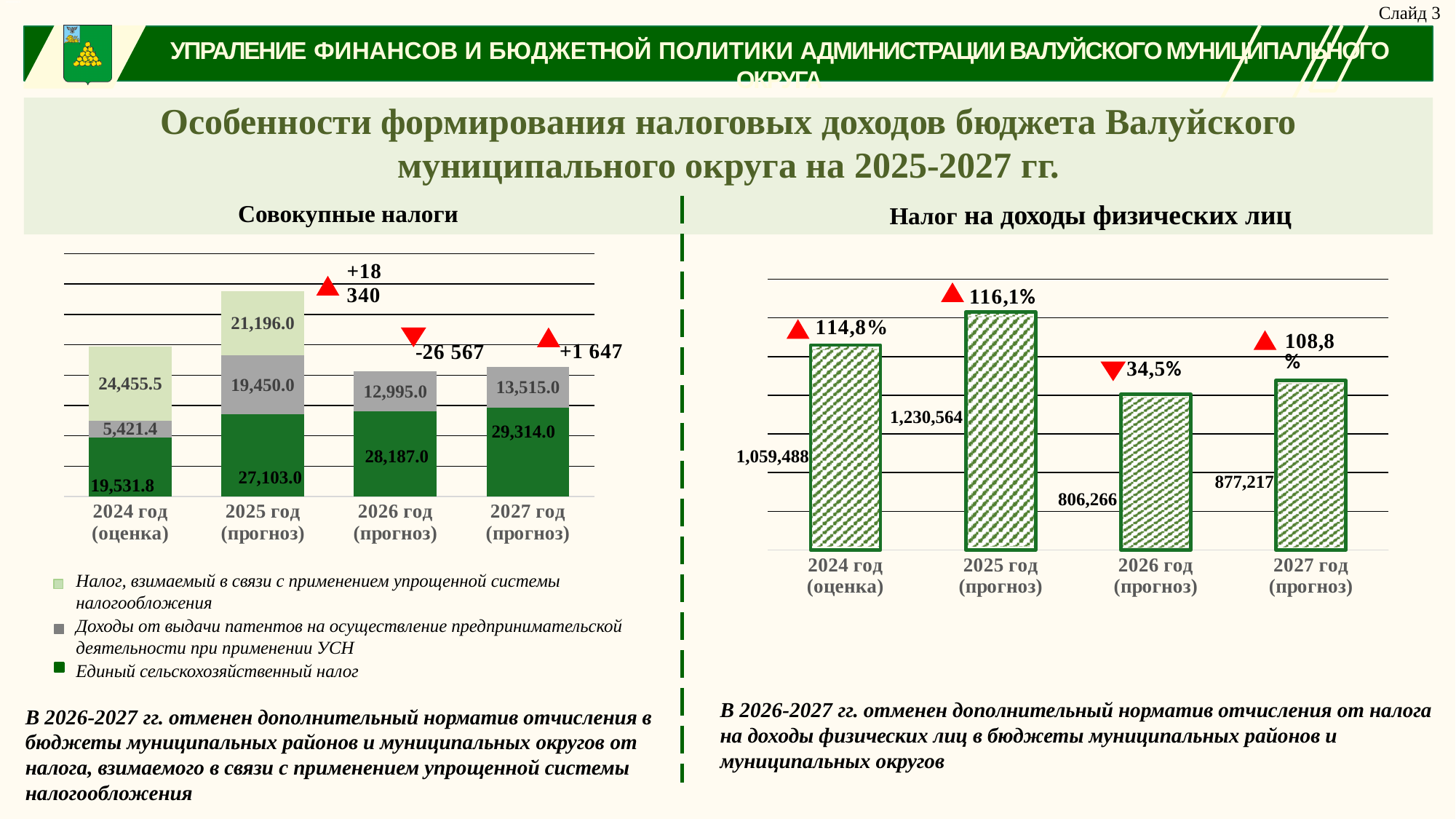
How many years are shown on the x axis of the chart 'Налог на доходы физических лиц'? 4 What kind of chart is 'Налог на доходы физических лиц'? bar chart In the chart 'Совокупные налоги', what is the total of the stacked bar for 2026 год (прогноз)? 41,182.0 In the chart 'Налог на доходы физических лиц', which year has the highest value? 2025 год (прогноз) In the chart 'Налог на доходы физических лиц', what is the value for 2025 год (прогноз)? 1,230,564 In the chart 'Совокупные налоги', is the value of Единый сельскохозяйственный налог larger for 2025 год (прогноз) or 2027 год (прогноз)? 2027 год (прогноз) In the chart 'Налог на доходы физических лиц', what is the difference between the values for 2025 год (прогноз) and 2024 год (оценка)? 171,076 In the chart 'Налог на доходы физических лиц', which year has the lowest value? 2026 год (прогноз) In the chart 'Совокупные налоги', what is the value of Доходы от выдачи патентов for 2024 год (оценка)? 5,421.4 How many series does the legend of the chart 'Совокупные налоги' list? 3 In the chart 'Совокупные налоги', what is the value of Единый сельскохозяйственный налог for 2026 год (прогноз)? 28,187.0 In the chart 'Совокупные налоги', does the value of Единый сельскохозяйственный налог rise or fall from 2024 to 2027? rises